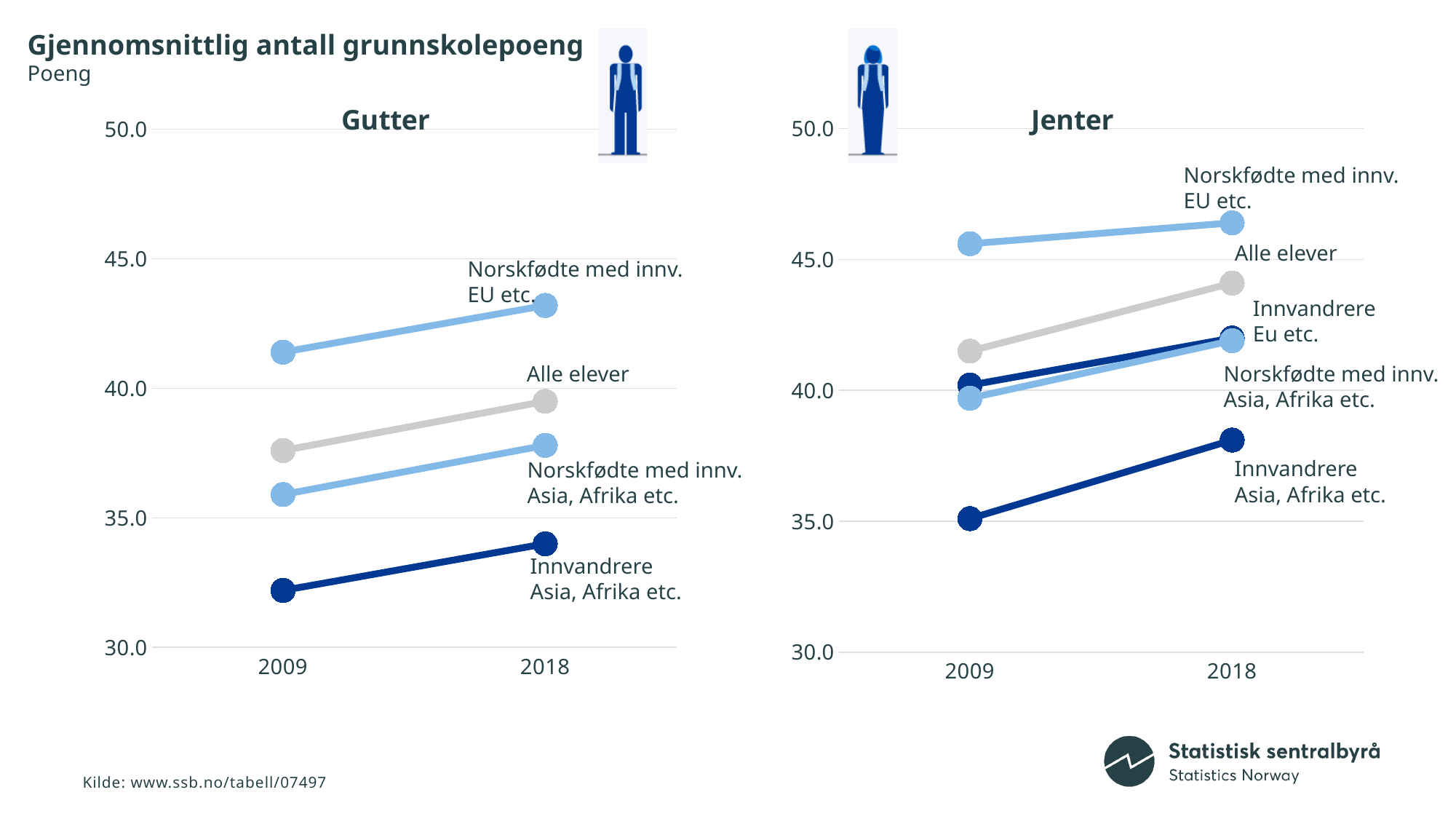
In the Jenter chart, which series has the lowest value in 2018? Innvandrere Asia, Afrika etc. What is the title of the slide's chart? Gjennomsnittlig antall grunnskolepoeng In the Jenter chart, is the value for Norskfødte med innv. EU etc. in 2009 greater or less than 45.0? greater In the Gutter chart, which series has the lowest value in 2009? Innvandrere Asia, Afrika etc. In the Gutter chart, does the value for Alle elever rise or fall from 2009 to 2018? rise What kind of chart is the Gutter chart? line chart In the Gutter chart, which series has the highest value in 2018? Norskfødte med innv. EU etc. In the Jenter chart, which is larger in 2018: Alle elever or Innvandrere Eu etc.? Alle elever How many series are plotted in the Jenter chart? 5 How many years are shown on the x axis of the Jenter chart? 2 In the Gutter chart, is the value for Innvandrere Asia, Afrika etc. in 2018 greater or less than 35.0? less